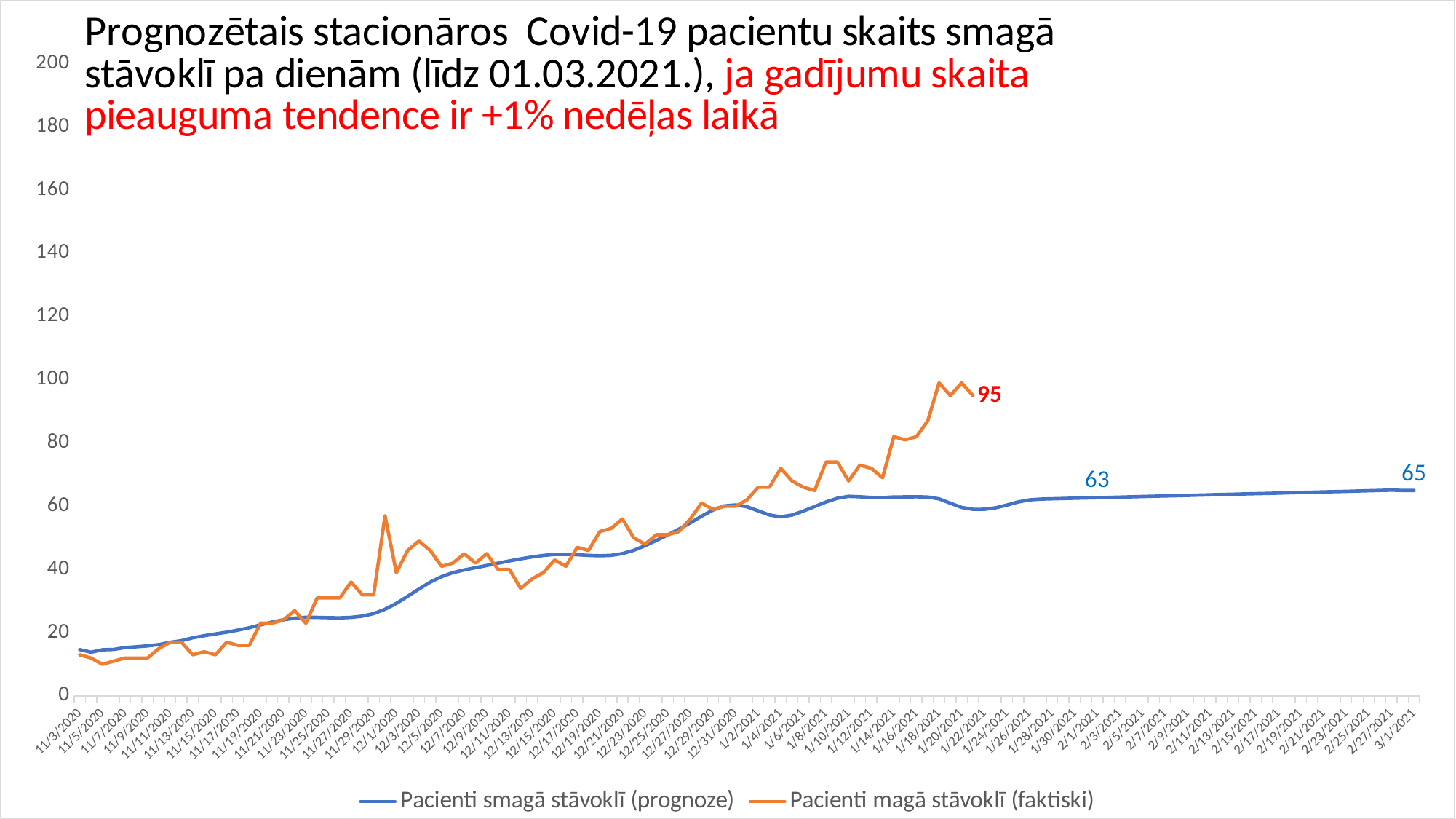
What is the last labelled value of the actual series (Pacienti magā stāvoklī (faktiski))? 95 Does the forecast line rise or fall overall from 11/3/2020 to 3/1/2021? rises What is the highest value shown on the vertical axis? 200 What colour is the line for Pacienti smagā stāvoklī (prognoze)? blue Which is larger: the last labelled actual value or the forecast value on 3/1/2021? the last labelled actual value (95) What is the difference between the last labelled actual value (95) and the final forecast value on 3/1/2021 (65)? 30 Is the actual series' peak around 12/1/2020 greater or less than 40? greater How many series does the legend list? 2 What is the forecast value (Pacienti smagā stāvoklī (prognoze)) labelled at the end of the chart on 3/1/2021? 65 What kind of chart is shown on the slide? line chart Is the forecast value on 11/3/2020 greater or less than 20? less Which two values are printed as data labels on the blue forecast line? 63 and 65